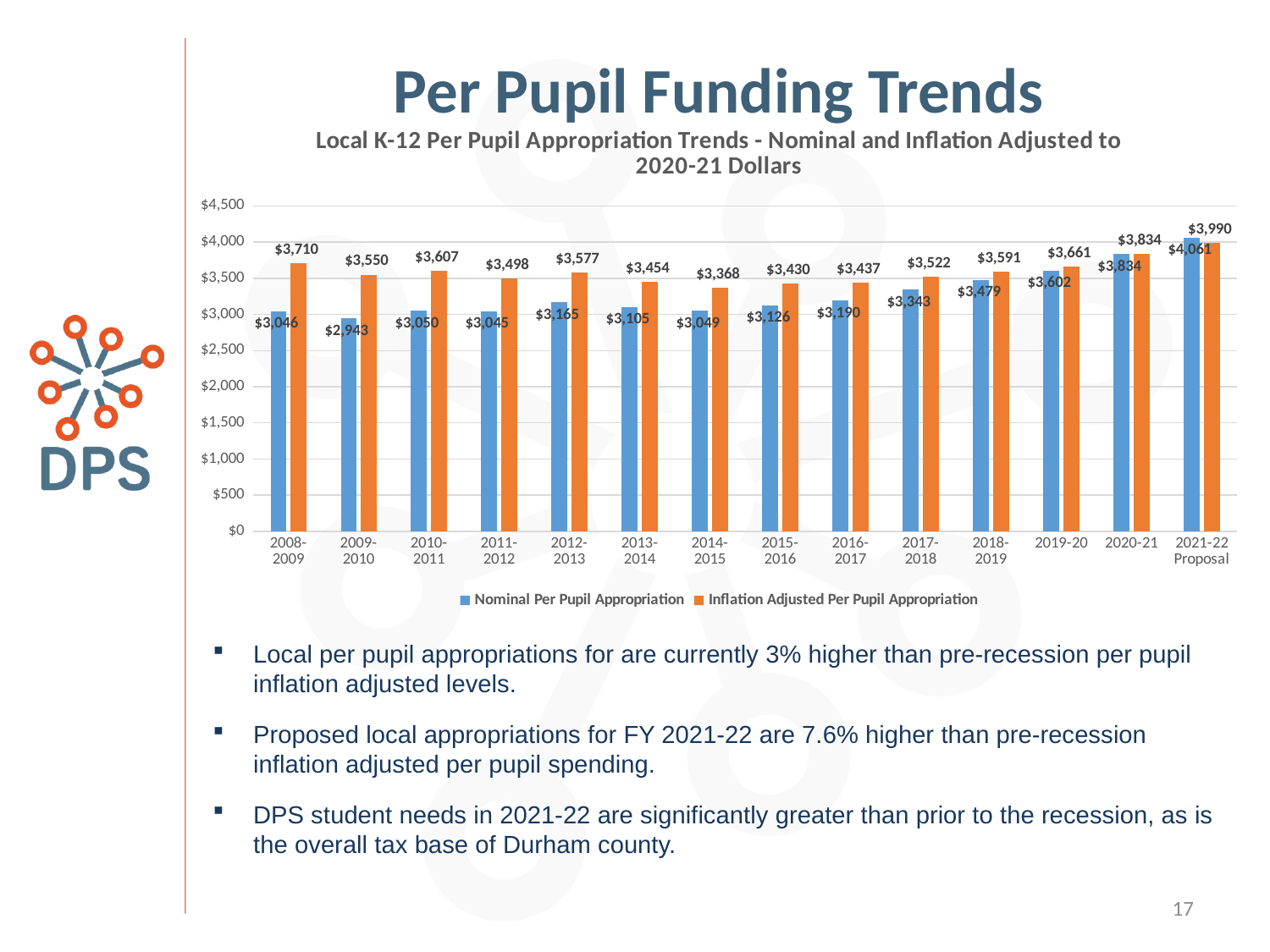
For the 2021-22 Proposal, which is larger: the Nominal or the Inflation Adjusted Per Pupil Appropriation? Nominal Per Pupil Appropriation Which year has the highest Nominal Per Pupil Appropriation? 2021-22 Proposal What kind of chart is shown on the slide? bar chart What is the title of the chart? Local K-12 Per Pupil Appropriation Trends - Nominal and Inflation Adjusted to 2020-21 Dollars How many series does the legend list? 2 What is the Nominal Per Pupil Appropriation for 2008-2009? $3,046 Which year has the lowest Nominal Per Pupil Appropriation? 2009-2010 Does the Nominal Per Pupil Appropriation generally rise or fall from 2014-2015 to the 2021-22 Proposal? rise What is the difference between the Inflation Adjusted and Nominal Per Pupil Appropriation in 2008-2009? $664 How many fiscal year categories are shown on the x axis? 14 Which year has the lowest Inflation Adjusted Per Pupil Appropriation? 2014-2015 What is the Inflation Adjusted Per Pupil Appropriation for the 2021-22 Proposal? $3,990